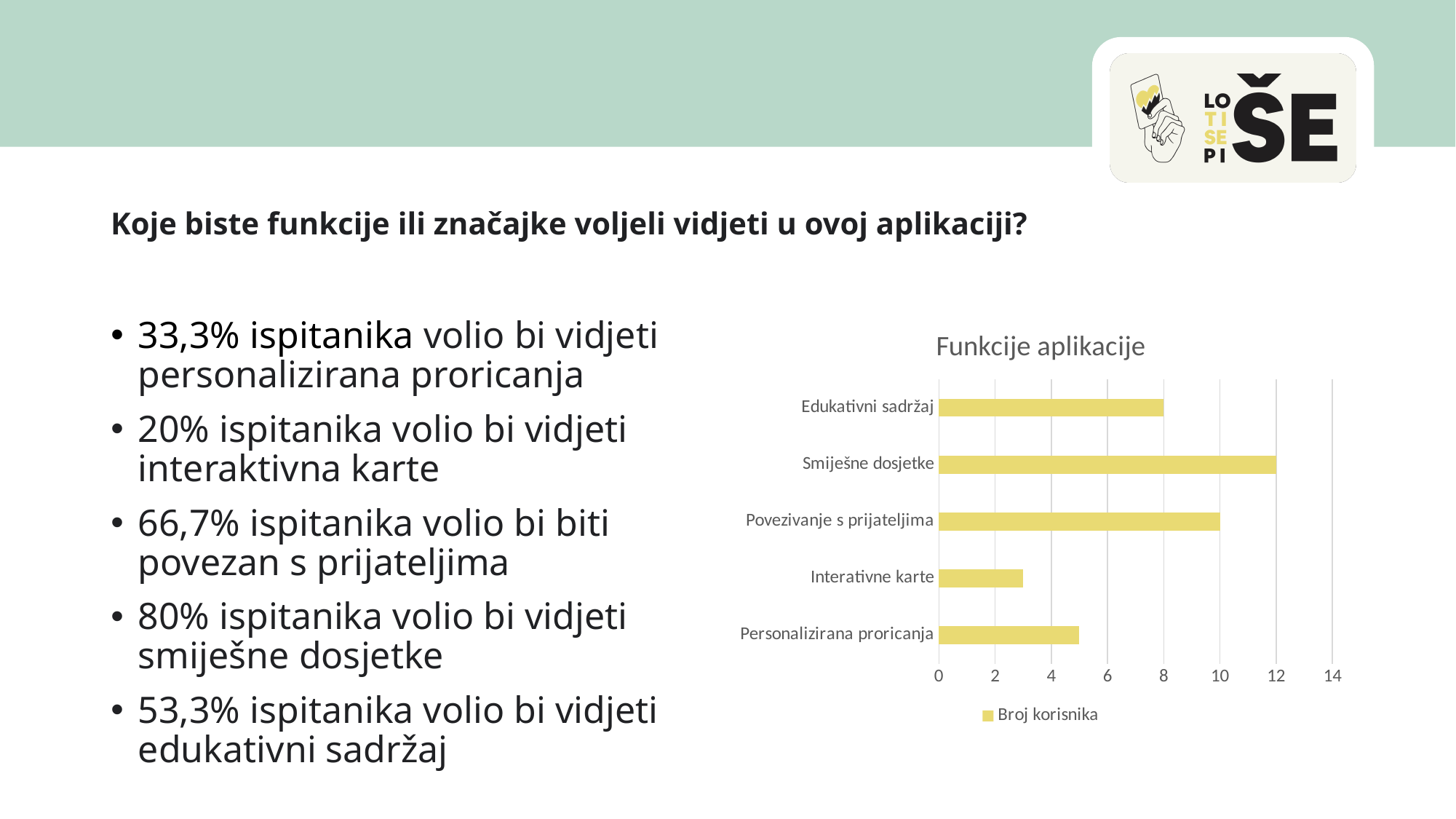
Is the value for Interativne karte greater or less than 4? less What is the difference between the values for Smiješne dosjetke and Edukativni sadržaj? 4 What is the title of the chart? Funkcije aplikacije Which category has the highest value? Smiješne dosjetke How many categories does the chart show? 5 Which category has the lowest value? Interativne karte What is the value for Edukativni sadržaj? 8 How many series does the legend list? 1 Which is larger, the value for Personalizirana proricanja or the value for Povezivanje s prijateljima? Povezivanje s prijateljima What is the value for Povezivanje s prijateljima? 10 What type of chart is shown on the slide? bar chart What is the value for Smiješne dosjetke? 12